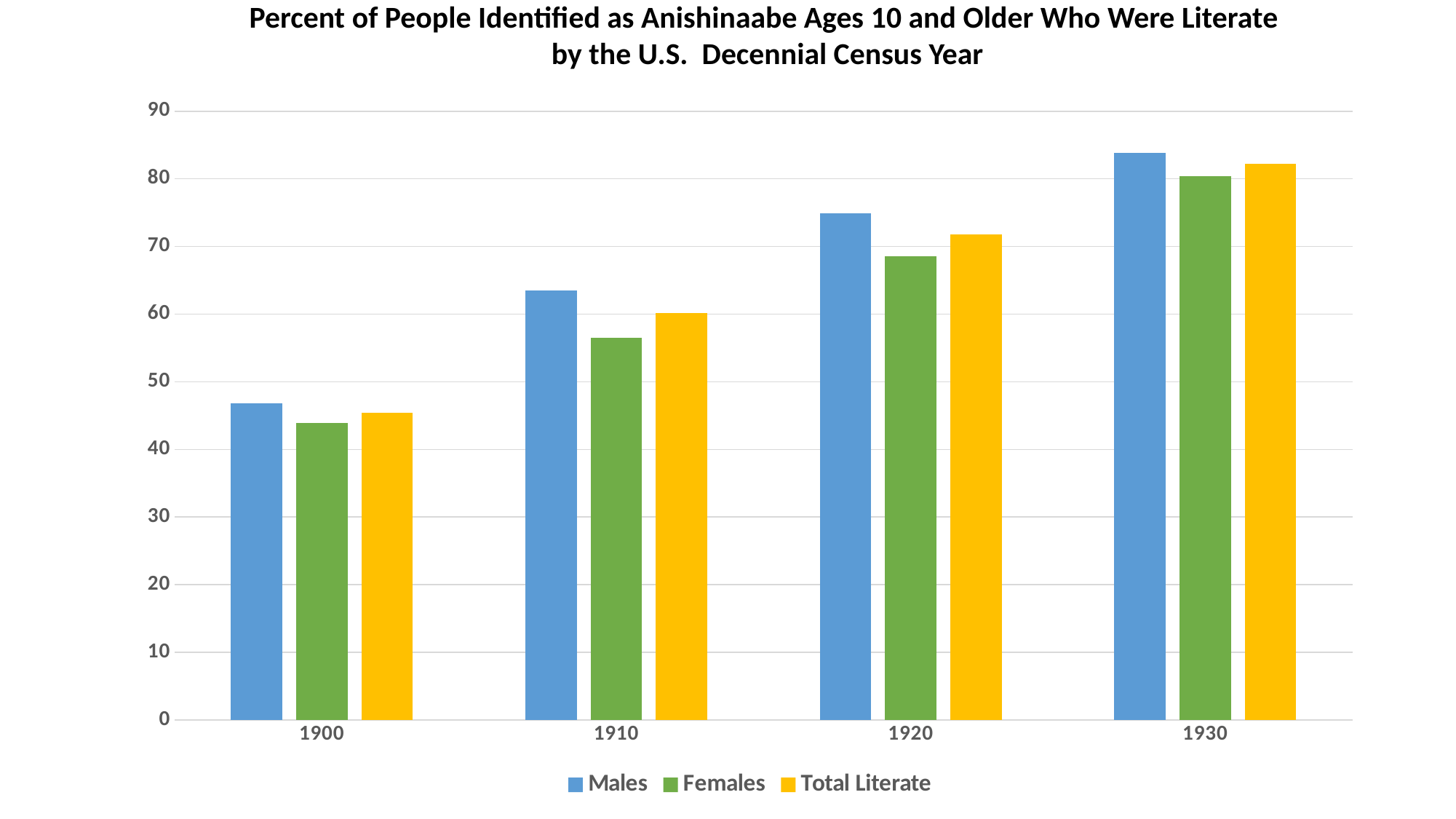
How many series does the legend list? 3 Which series is shown in yellow? Total Literate How many census years are shown on the x axis? 4 What kind of chart is shown on the slide? bar chart Which census year has the highest value for Males? 1930 Is the value for Females in 1920 greater or less than 60? greater Do the Total Literate values rise or fall from 1900 to 1930? rise Is the value for Total Literate in 1930 greater or less than 80? greater Is the value for Females in 1910 greater or less than 60? less Which census year has the lowest value for Females? 1900 In 1920, which is larger, the value for Males or the value for Females? Males